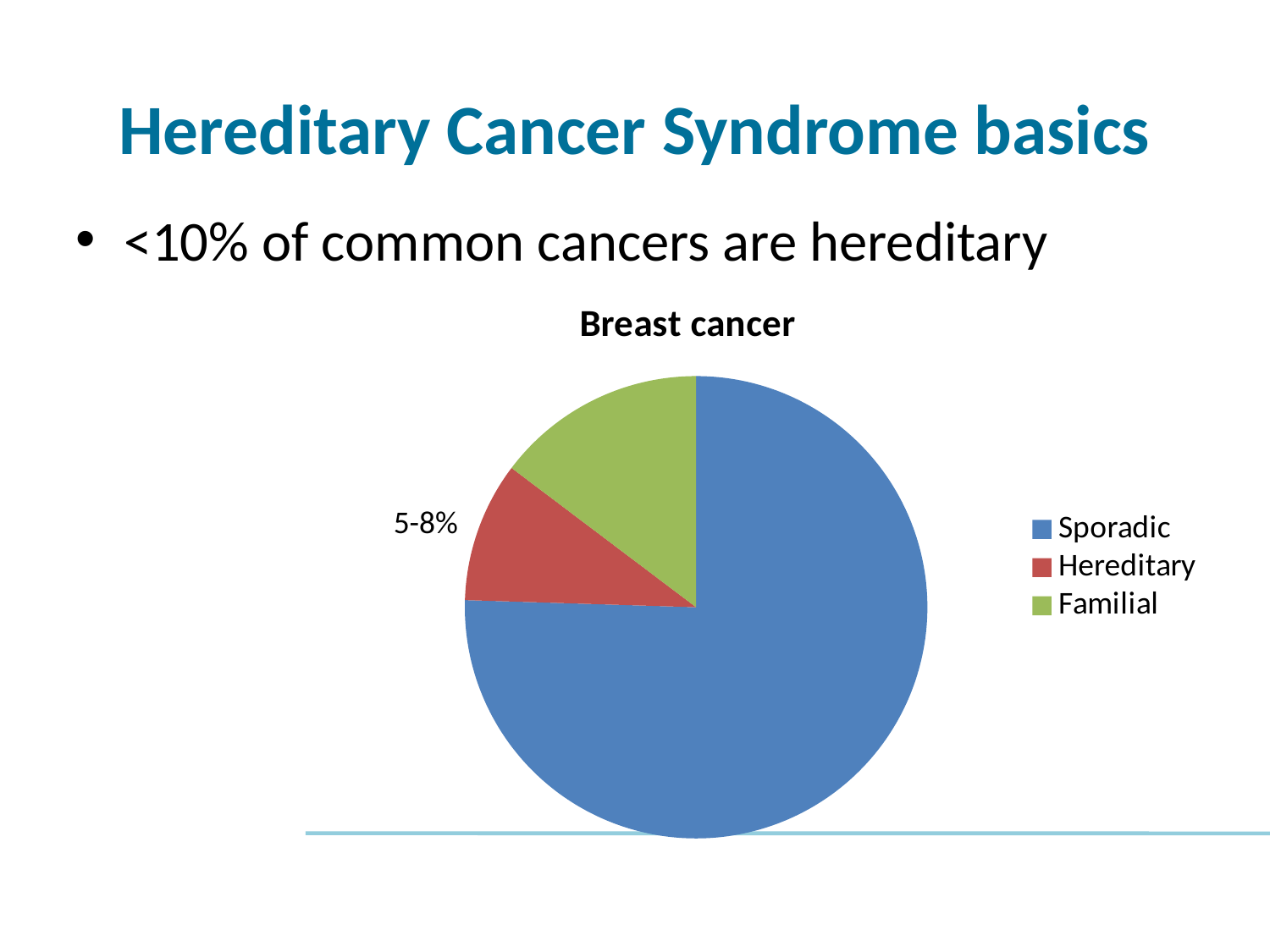
What value is labelled on the Hereditary slice? 5-8% What colour is the Sporadic slice? blue What kind of chart is shown on the slide? pie chart Which category has the smallest slice of the pie? Hereditary Which slice is larger, Hereditary or Familial? Familial Which slice is larger, Sporadic or Familial? Sporadic Which category has the largest slice of the pie? Sporadic How many slices does the pie chart have? 3 What is the title of the chart? Breast cancer How many entries does the legend list? 3